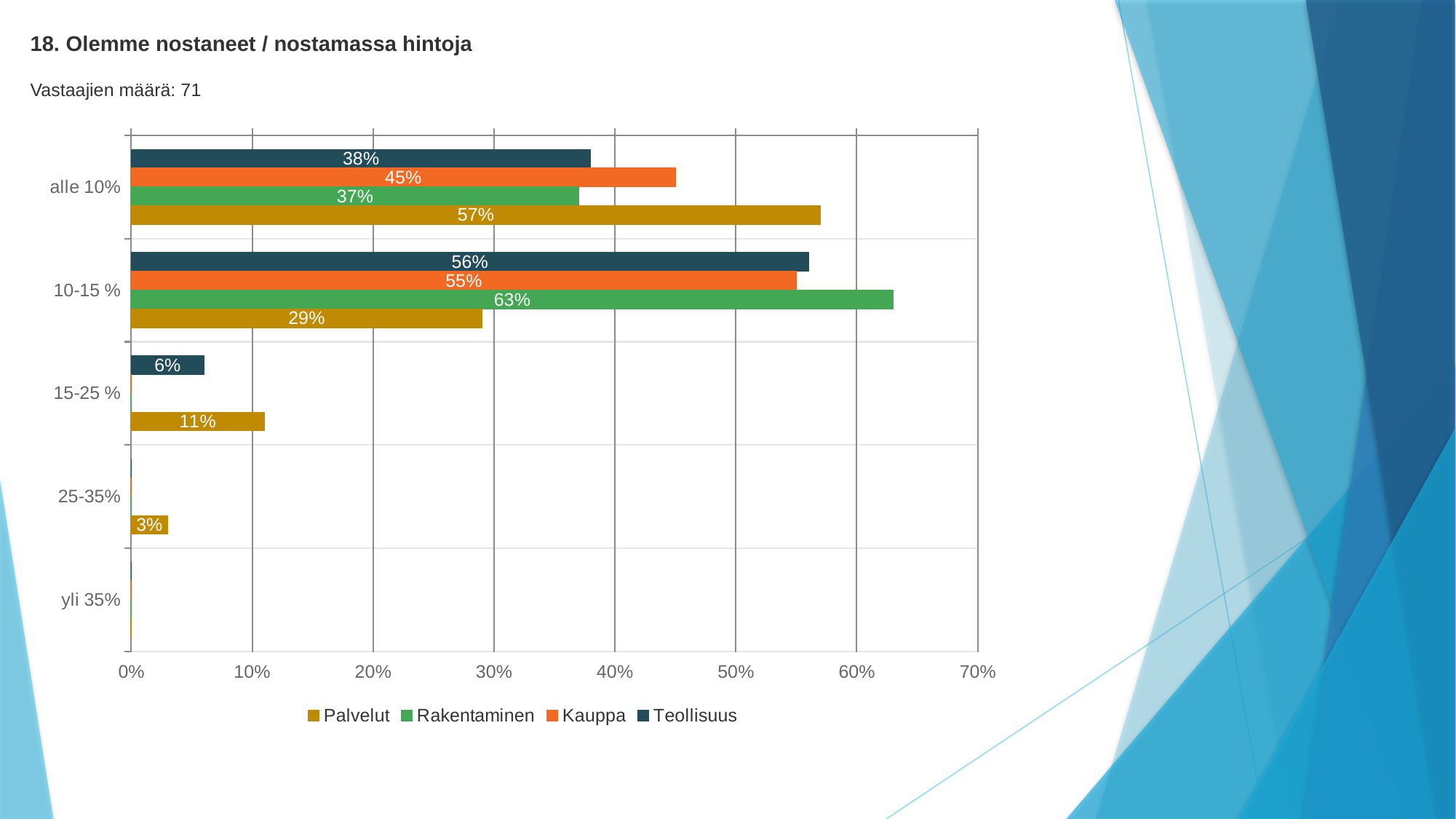
How many categories are shown on the vertical axis? 5 What is the value for Rakentaminen in the '10-15 %' category? 63% What is the value for Teollisuus in the '15-25 %' category? 6% Is the value for Rakentaminen in the '10-15 %' category greater or less than 60%? greater What is the value for Palvelut in the 'alle 10%' category? 57% Which is larger in the 'alle 10%' category: Teollisuus or Kauppa? Kauppa What kind of chart is shown on the slide? Bar chart How many series does the legend list? 4 Which series has the lowest value in the 'alle 10%' category? Rakentaminen What is the difference between the Palvelut values for 'alle 10%' and '10-15 %'? 28% What is the value for Kauppa in the 'alle 10%' category? 45% Which series has the highest value in the '10-15 %' category? Rakentaminen